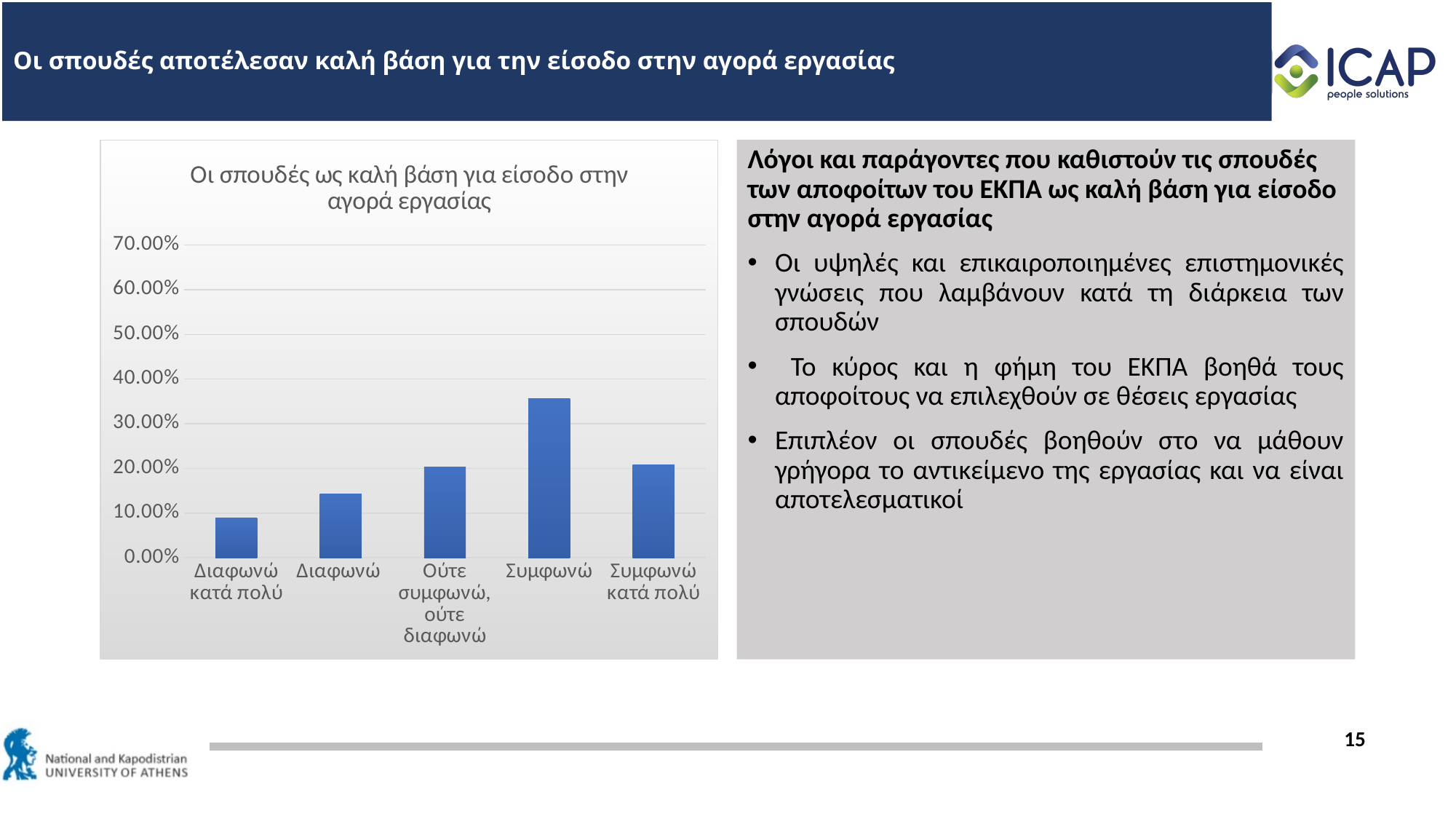
Which category has the highest bar in the chart? Συμφωνώ Is the value for Ούτε συμφωνώ, ούτε διαφωνώ greater or less than 30.00%? less Which is larger, the value for Διαφωνώ κατά πολύ or the value for Συμφωνώ κατά πολύ? Συμφωνώ κατά πολύ Which is larger, the value for Συμφωνώ or the value for Διαφωνώ? Συμφωνώ Which category has the lowest bar in the chart? Διαφωνώ κατά πολύ How many categories are shown on the x axis of the chart? 5 Is the value for Συμφωνώ κατά πολύ greater or less than 30.00%? less Is the value for Διαφωνώ κατά πολύ greater or less than 10.00%? less What is the title of the chart? Οι σπουδές ως καλή βάση για είσοδο στην αγορά εργασίας What kind of chart is shown on the slide? bar chart